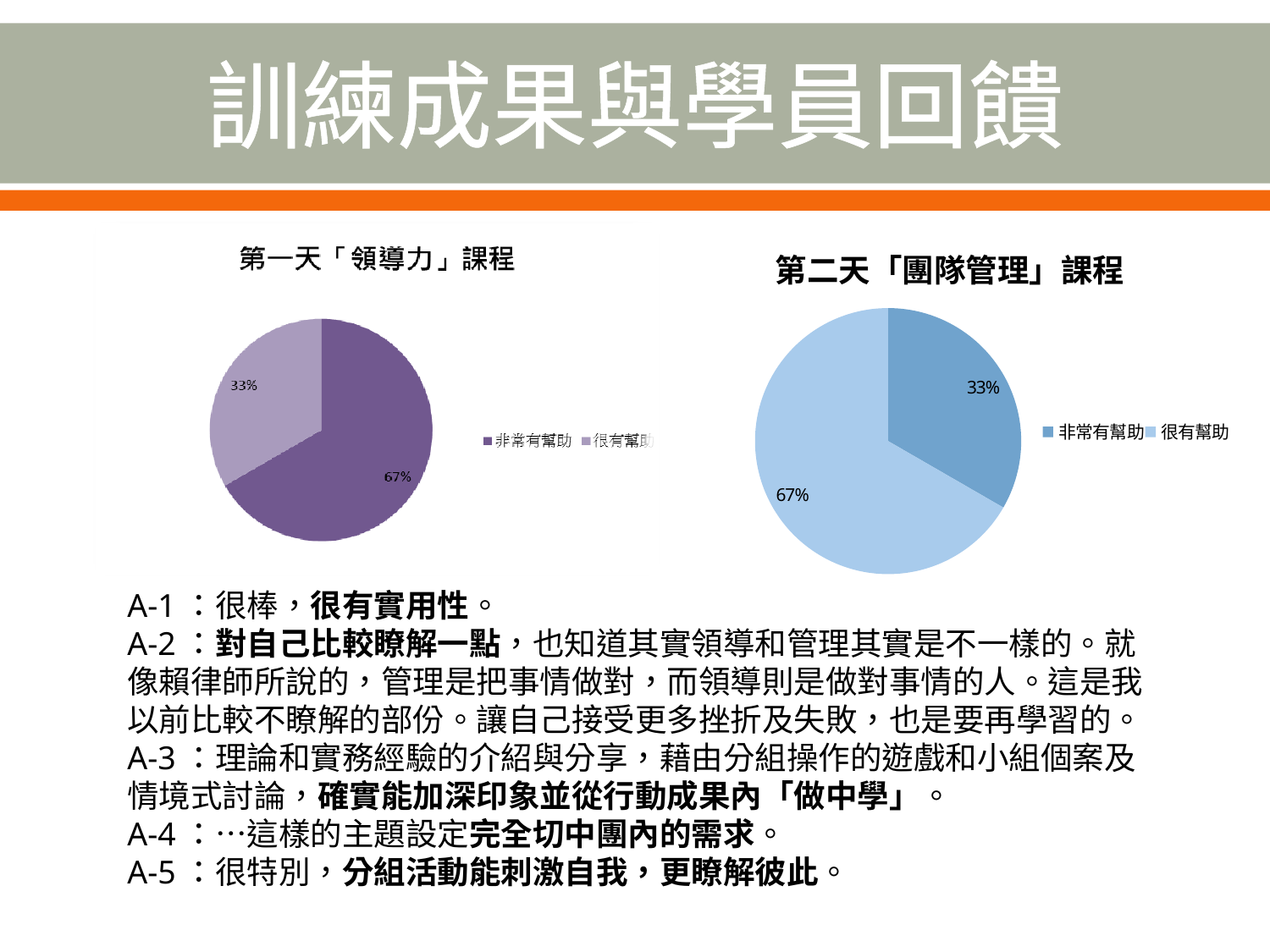
In the 第二天「團隊管理」課程 chart, what share is labelled for 很有幫助? 67% In the 第二天「團隊管理」課程 chart, what is the difference between the 很有幫助 and 非常有幫助 shares? 34% In the 第二天「團隊管理」課程 chart, what share is labelled for 非常有幫助? 33% How many slices does the 第二天「團隊管理」課程 pie chart have? 2 How many entries does the legend of the 第一天「領導力」課程 chart list? 2 In the 第一天「領導力」課程 chart, what share is labelled for 很有幫助? 33% In the 第一天「領導力」課程 chart, which category has the largest slice? 非常有幫助 In the 第二天「團隊管理」課程 chart, which category has the smallest slice? 非常有幫助 In the 第一天「領導力」課程 chart, what share is labelled for 非常有幫助? 67% In the 第一天「領導力」課程 chart, which is larger, 非常有幫助 or 很有幫助? 非常有幫助 What kind of chart is the 第一天「領導力」課程 chart? pie chart What is the title of the chart on the right side of the slide? 第二天「團隊管理」課程